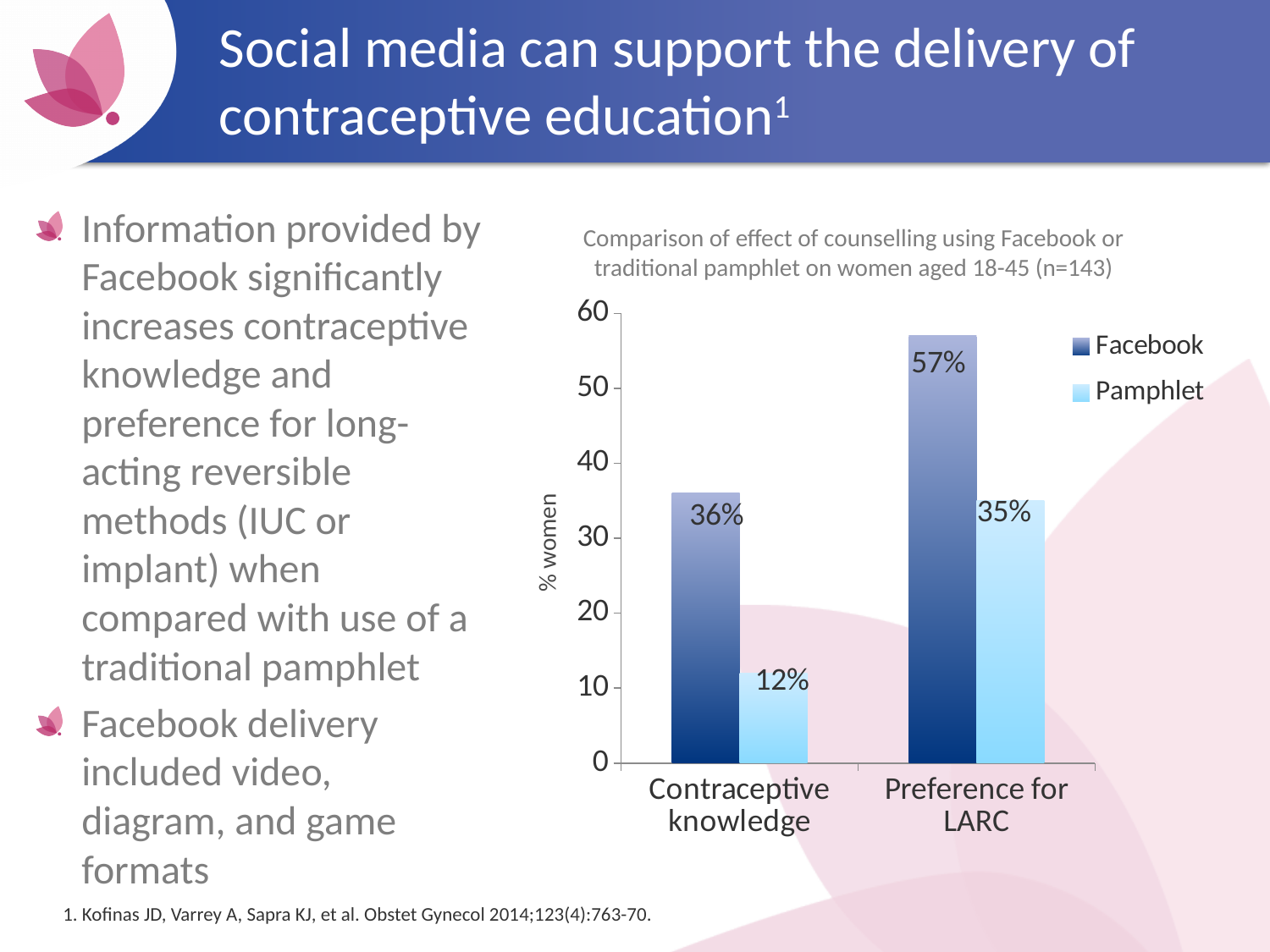
What is the Pamphlet value for Preference for LARC? 35% How many categories are shown on the x axis? 2 What is the Pamphlet value for Contraceptive knowledge? 12% What is the Facebook value for Preference for LARC? 57% How many series does the legend list? 2 What kind of chart is shown on the slide? Bar chart Which bar in the chart has the highest value? Facebook, Preference for LARC What is the difference between the Facebook and Pamphlet values for Preference for LARC? 22% What is the Facebook value for Contraceptive knowledge? 36% Which bar in the chart has the lowest value? Pamphlet, Contraceptive knowledge What is the difference between the Facebook and Pamphlet values for Contraceptive knowledge? 24% Which is larger for Preference for LARC, Facebook or Pamphlet? Facebook